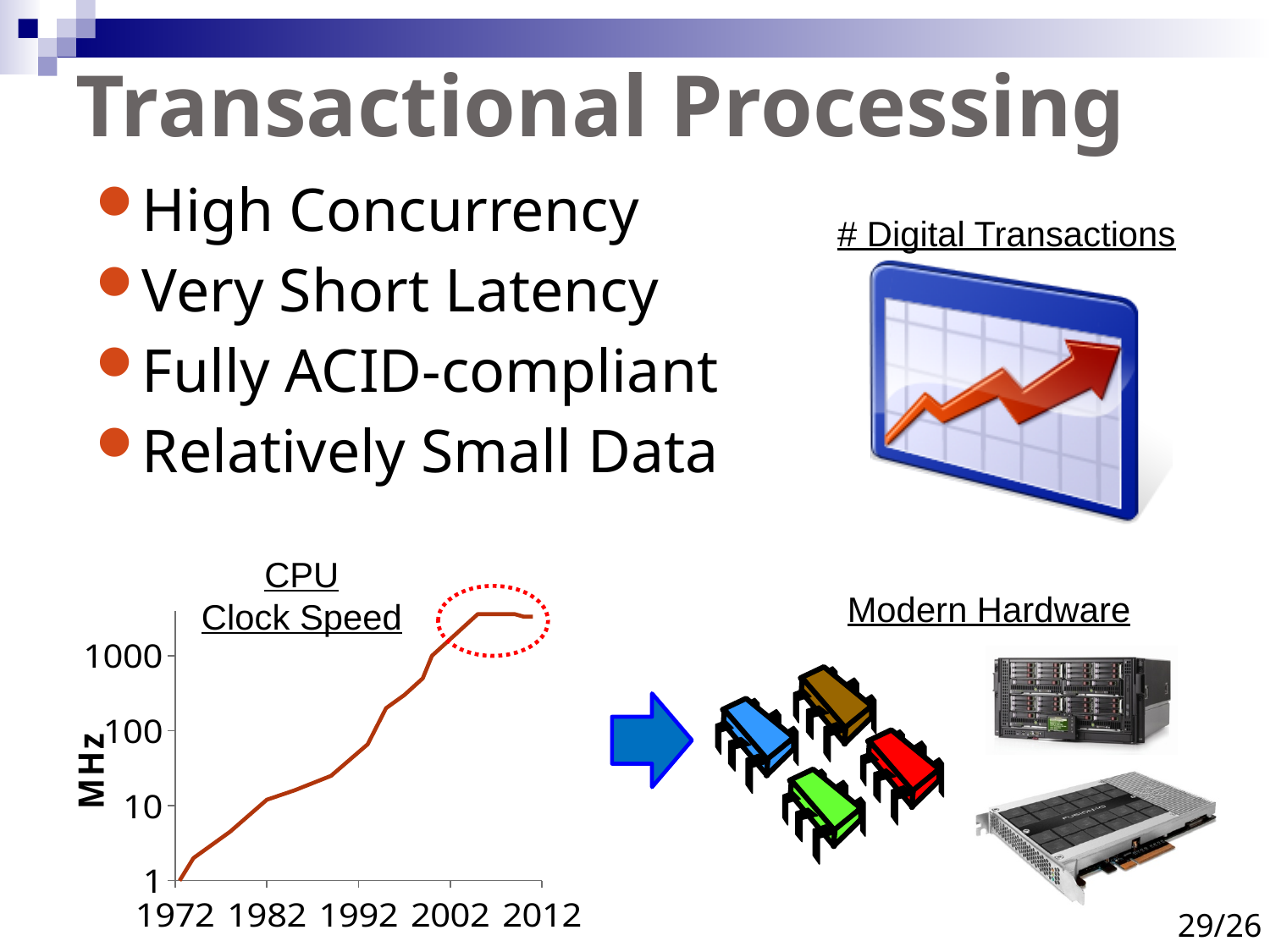
In the CPU Clock Speed chart, is the value for 2012 greater or less than 1000? greater What unit is shown on the y-axis of the CPU Clock Speed chart? MHz How many lines are plotted in the CPU Clock Speed chart? 1 In the CPU Clock Speed chart, is the value for 1982 greater or less than 100? less How many year labels are shown on the x-axis of the CPU Clock Speed chart? 5 What is the title of the chart in the lower left of the slide? CPU Clock Speed What is the first year labelled on the x-axis of the CPU Clock Speed chart? 1972 In the CPU Clock Speed chart, is the value for 1992 greater or less than 10? greater What kind of chart is the CPU Clock Speed chart? line chart In the CPU Clock Speed chart, does the clock speed generally rise or fall from 1972 to 2012? rise In the CPU Clock Speed chart, which year has the higher clock speed, 1982 or 2002? 2002